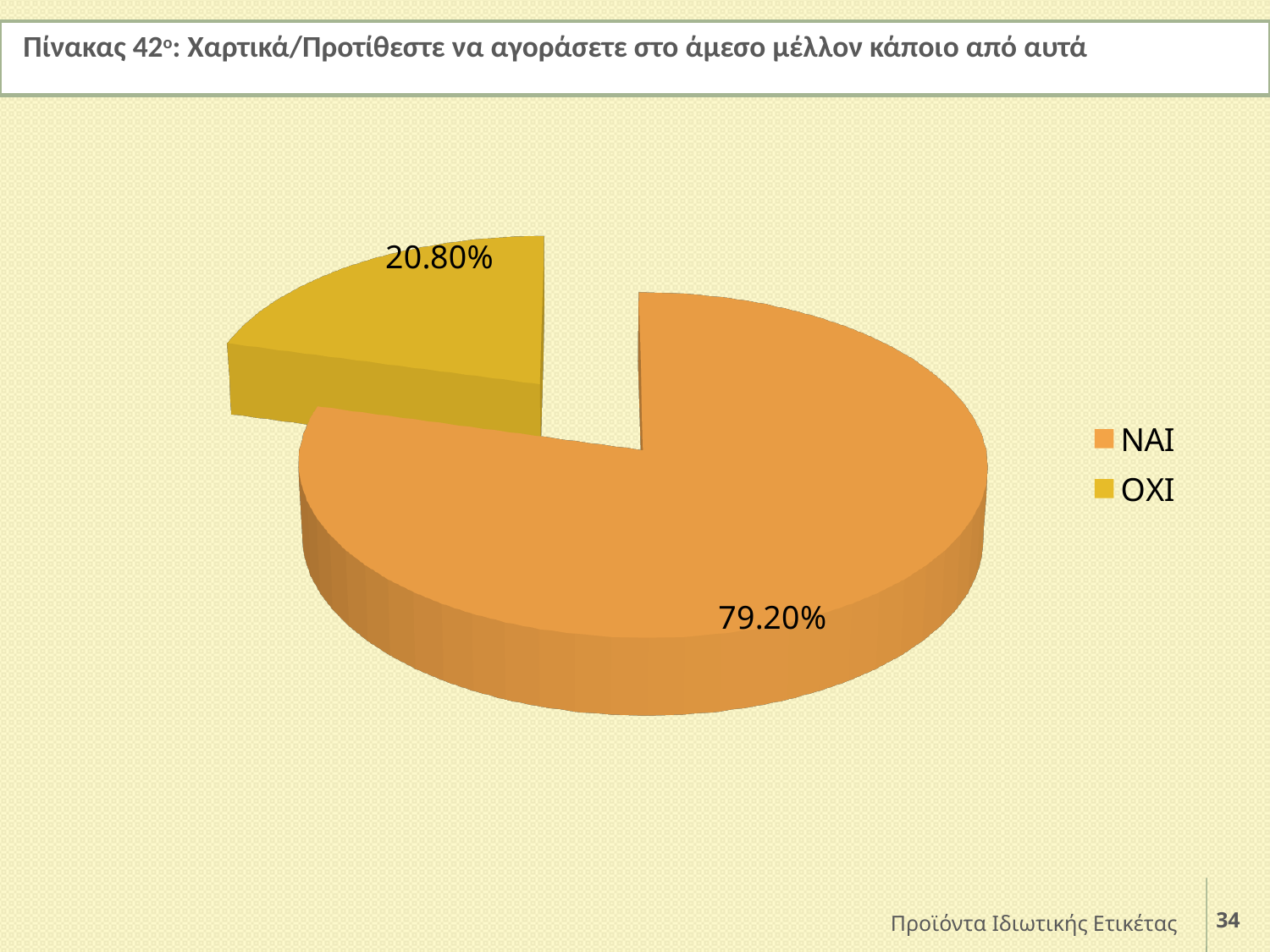
Which slice is pulled out (exploded) from the pie? ΟΧΙ What is the difference in percentage points between the ΝΑΙ and ΟΧΙ slices? 58.40 What kind of chart is shown on the slide? Pie chart What share of the pie does the ΟΧΙ slice represent? 20.80% How many entries does the legend list? 2 Which slice of the pie is the smallest? ΟΧΙ What percentage of the pie is labelled ΝΑΙ? 79.20% Which is larger, the ΝΑΙ slice or the ΟΧΙ slice? ΝΑΙ Which slice of the pie is the largest? ΝΑΙ What percentage of the pie is labelled ΟΧΙ? 20.80% How many slices does the pie chart have? 2 What colour is the ΝΑΙ slice in the pie chart? Orange